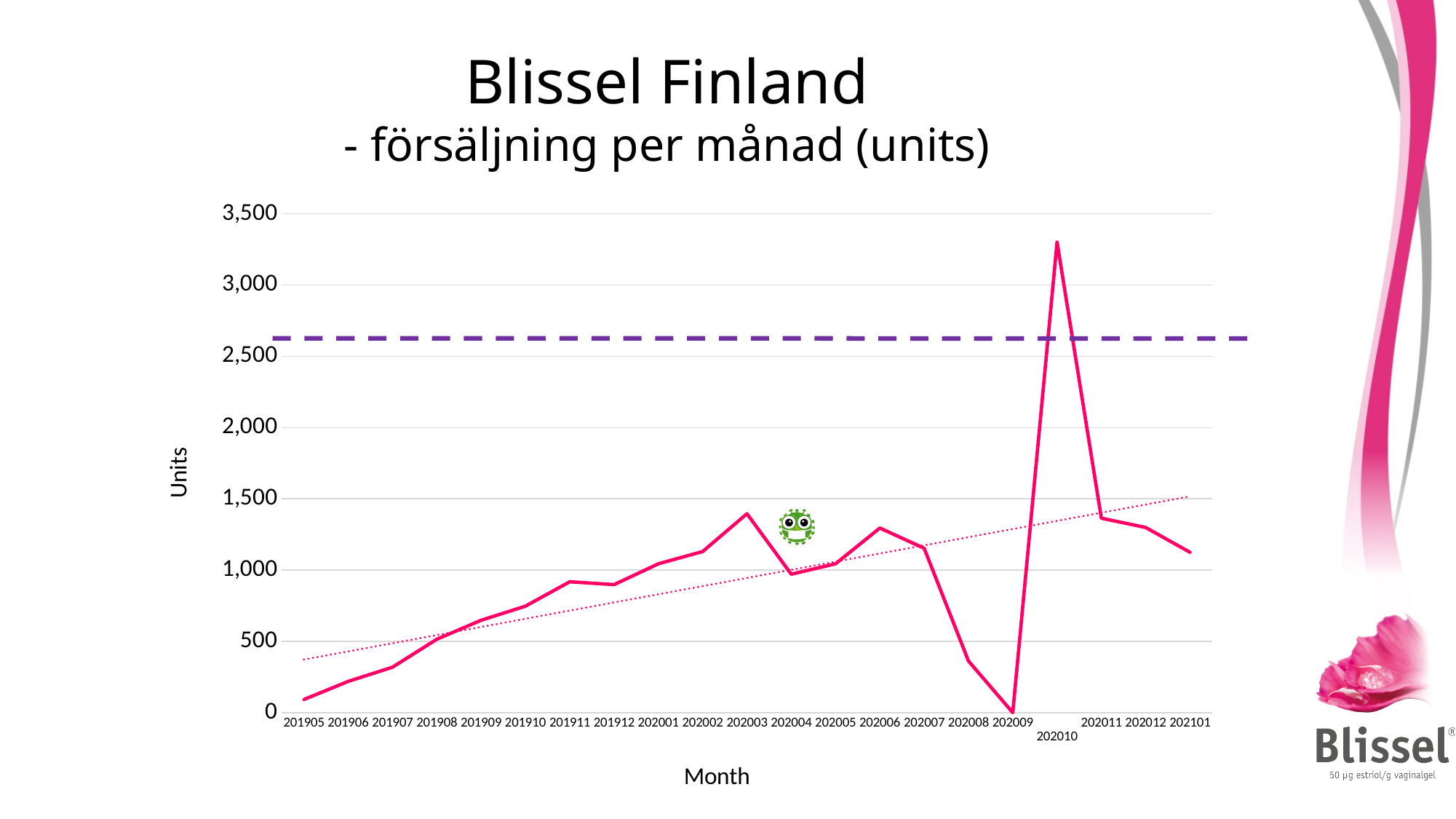
Which month has the lowest value? 202009 What is the label on the vertical axis? Units Is the value for 202010 greater or less than 3,000? greater Is the value for 201905 greater or less than 500? less How many months are plotted along the x axis? 21 What kind of chart is shown on the slide? line chart Which month has the highest value? 202010 Is the value for 202008 greater or less than 500? less Which is larger, the value for 202010 or the value for 202011? 202010 Which is larger, the value for 202003 or the value for 202004? 202003 Do the values generally rise or fall from 201905 to 202003? rise